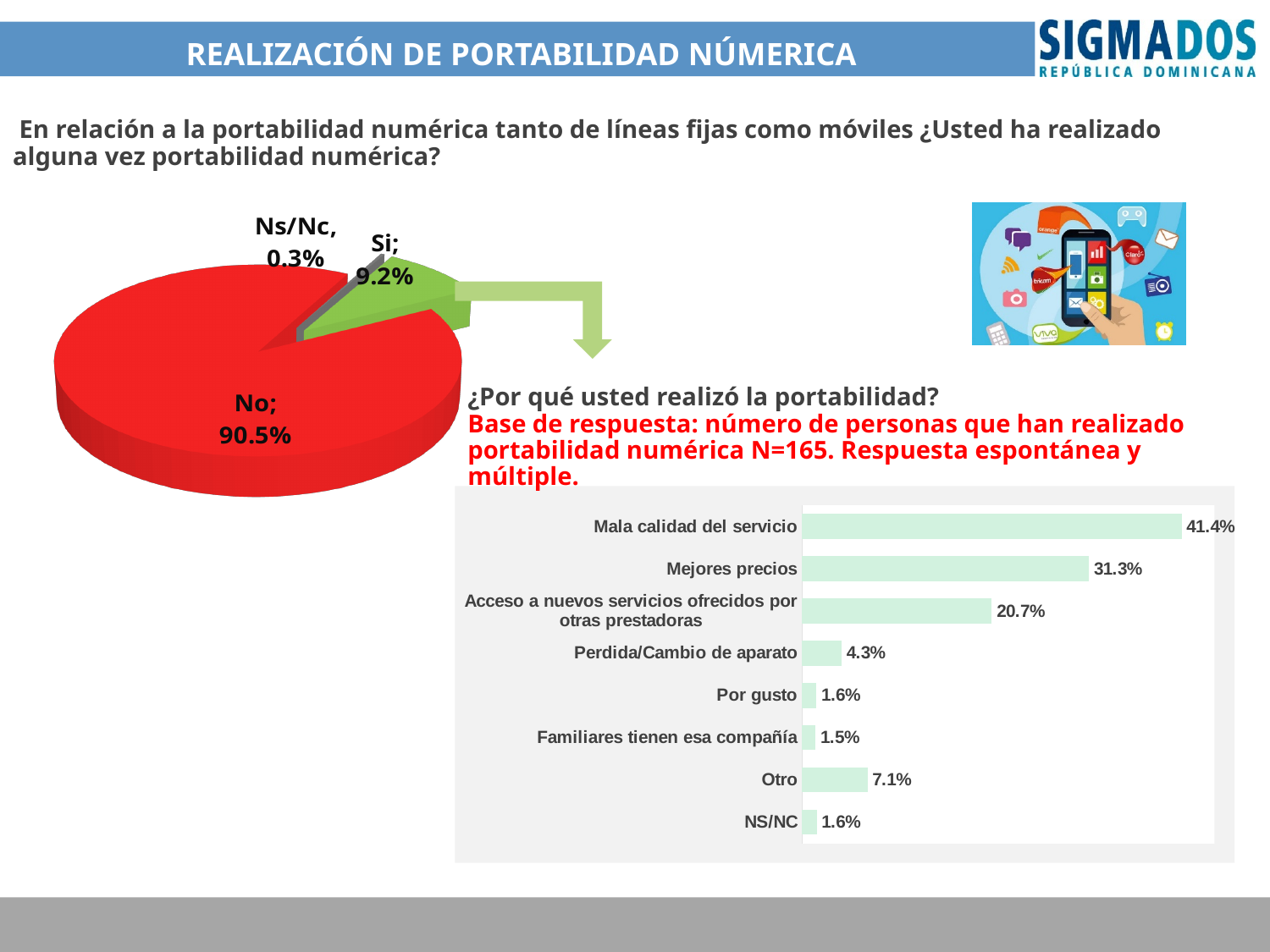
In the bar chart on the right (¿Por qué usted realizó la portabilidad?), which category has the highest value? Mala calidad del servicio In the pie chart on the left, which category has the smallest slice? Ns/Nc In the bar chart on the right (¿Por qué usted realizó la portabilidad?), which is larger: "Otro" or "Perdida/Cambio de aparato"? Otro In the pie chart on the left, how many slices are there? 3 In the pie chart on the left, what share of respondents answered "No"? 90.5% In the bar chart on the right (¿Por qué usted realizó la portabilidad?), what is the value for "Acceso a nuevos servicios ofrecidos por otras prestadoras"? 20.7% What type of chart is shown on the right side of the slide under "¿Por qué usted realizó la portabilidad?"? Bar chart In the pie chart on the left, what share of respondents answered "Ns/Nc"? 0.3% In the bar chart on the right (¿Por qué usted realizó la portabilidad?), what is the difference between "Mala calidad del servicio" and "Mejores precios"? 10.1% In the pie chart on the left, what share of respondents answered "Si"? 9.2% In the bar chart on the right (¿Por qué usted realizó la portabilidad?), how many categories are shown? 8 In the bar chart on the right (¿Por qué usted realizó la portabilidad?), what is the value for "Mala calidad del servicio"? 41.4%